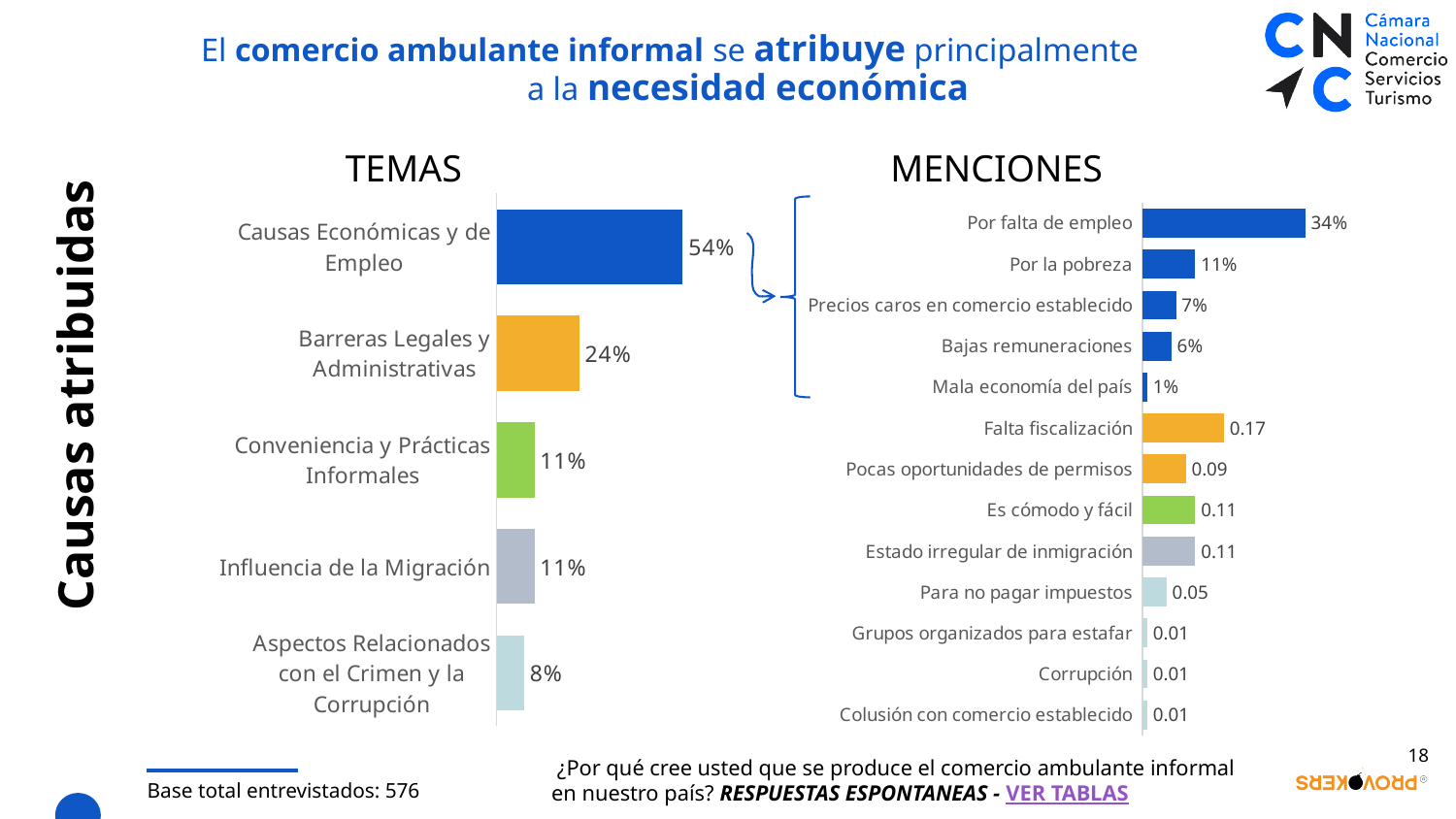
In the TEMAS chart, what is the difference between Causas Económicas y de Empleo and Barreras Legales y Administrativas? 30% What kind of chart is the MENCIONES chart? Bar chart In the TEMAS chart, what is the value for Causas Económicas y de Empleo? 54% In the TEMAS chart, what is the value for Barreras Legales y Administrativas? 24% In the MENCIONES chart, which category has the highest value? Por falta de empleo In the TEMAS chart, which category has the lowest value? Aspectos Relacionados con el Crimen y la Corrupción In the MENCIONES chart, what is the value for Para no pagar impuestos? 0.05 In the MENCIONES chart, what is the value for Por falta de empleo? 34% How many categories are shown in the TEMAS chart? 5 In the MENCIONES chart, what is the value for Falta fiscalización? 0.17 How many categories are shown in the MENCIONES chart? 13 In the MENCIONES chart, which is larger: Por la pobreza or Bajas remuneraciones? Por la pobreza